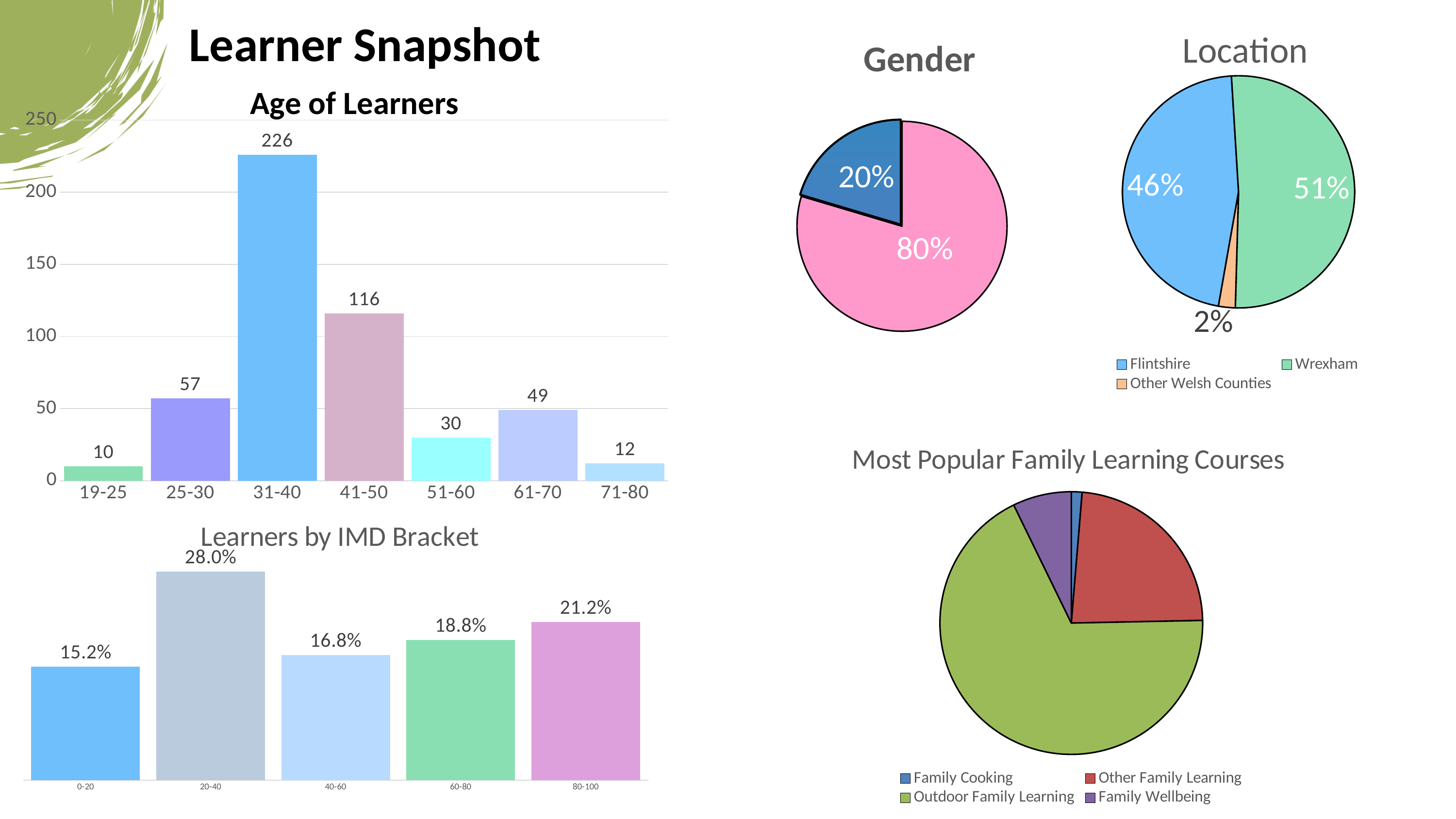
In the Age of Learners chart, what is the difference between the 41-50 and 61-70 groups? 67 In the Location pie chart, which category has the smallest share? Other Welsh Counties What kind of chart is the Learners by IMD Bracket chart? bar chart In the Learners by IMD Bracket chart, what is the difference between the 80-100 and 40-60 brackets? 4.4% In the Age of Learners chart, which age group has the fewest learners? 19-25 In the Learners by IMD Bracket chart, which bracket has the lowest percentage? 0-20 In the Most Popular Family Learning Courses pie chart, which course has the largest slice? Outdoor Family Learning In the Learners by IMD Bracket chart, what is the value for the 20-40 bracket? 28.0% In the Age of Learners chart, how many learners are in the 31-40 age group? 226 In the Age of Learners chart, which is larger, the value for 25-30 or the value for 51-60? 25-30 In the Location pie chart, what share is Wrexham? 51% In the Age of Learners chart, how many age groups are shown on the x axis? 7